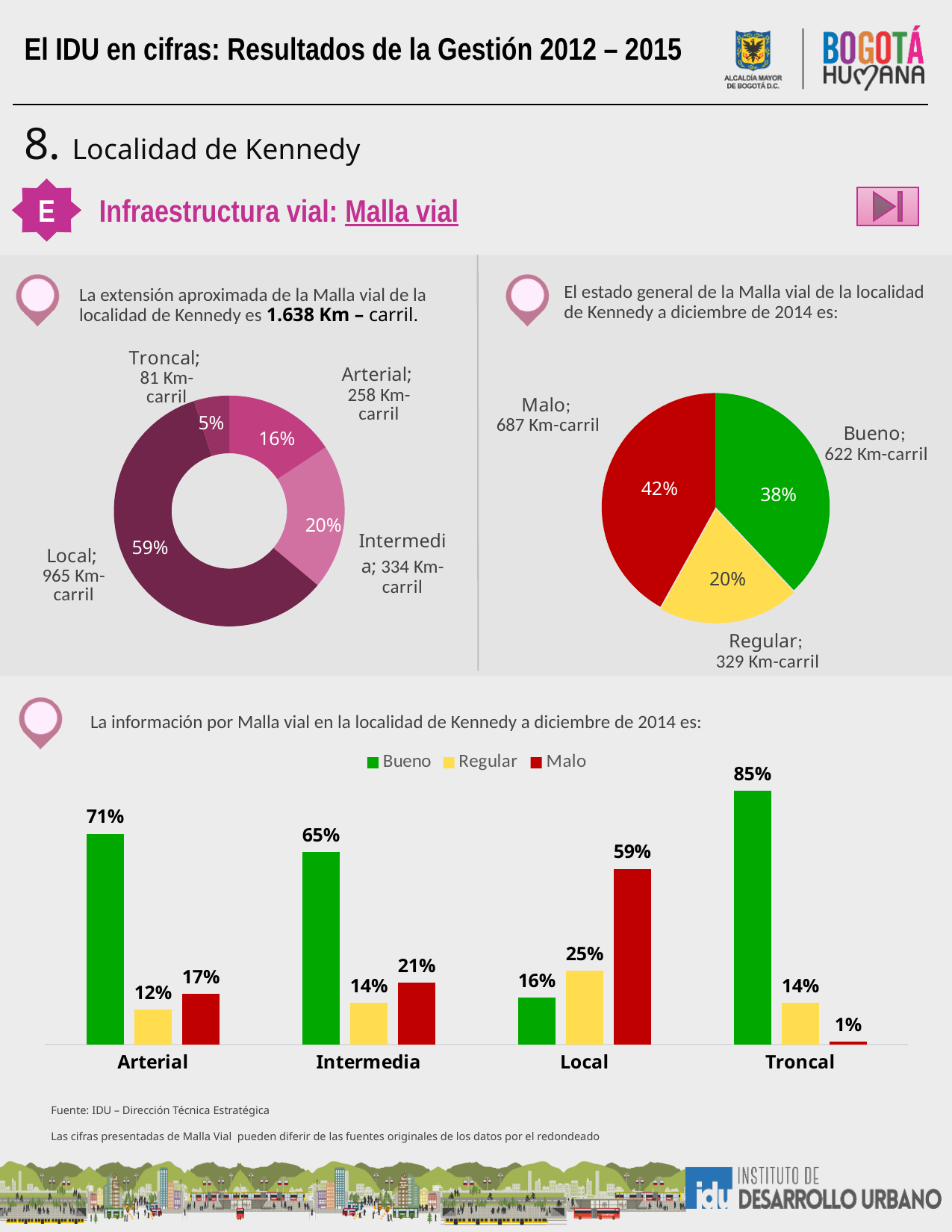
In the bar chart at the bottom, which category has the highest Malo value? Local In the pie chart on the right, how many Km-carril are in Regular state? 329 Km-carril What type of chart is the chart at the bottom of the slide? Bar chart In the donut chart on the left, which category has the smallest share? Troncal In the bar chart at the bottom, what is the Bueno value for Troncal? 85% In the pie chart on the right (estado general de la Malla vial), what share is Malo? 42% In the bar chart at the bottom, what is the difference between the Bueno and Malo values for Arterial? 54% In the donut chart on the left, how many Km-carril does Arterial have? 258 Km-carril In the bar chart at the bottom, how many series does the legend list? 3 In the donut chart on the left (extension of the Malla vial), what share does Local represent? 59% In the donut chart on the left, how many categories are shown? 4 In the pie chart on the right, what is the difference in Km-carril between Malo and Bueno? 65 Km-carril